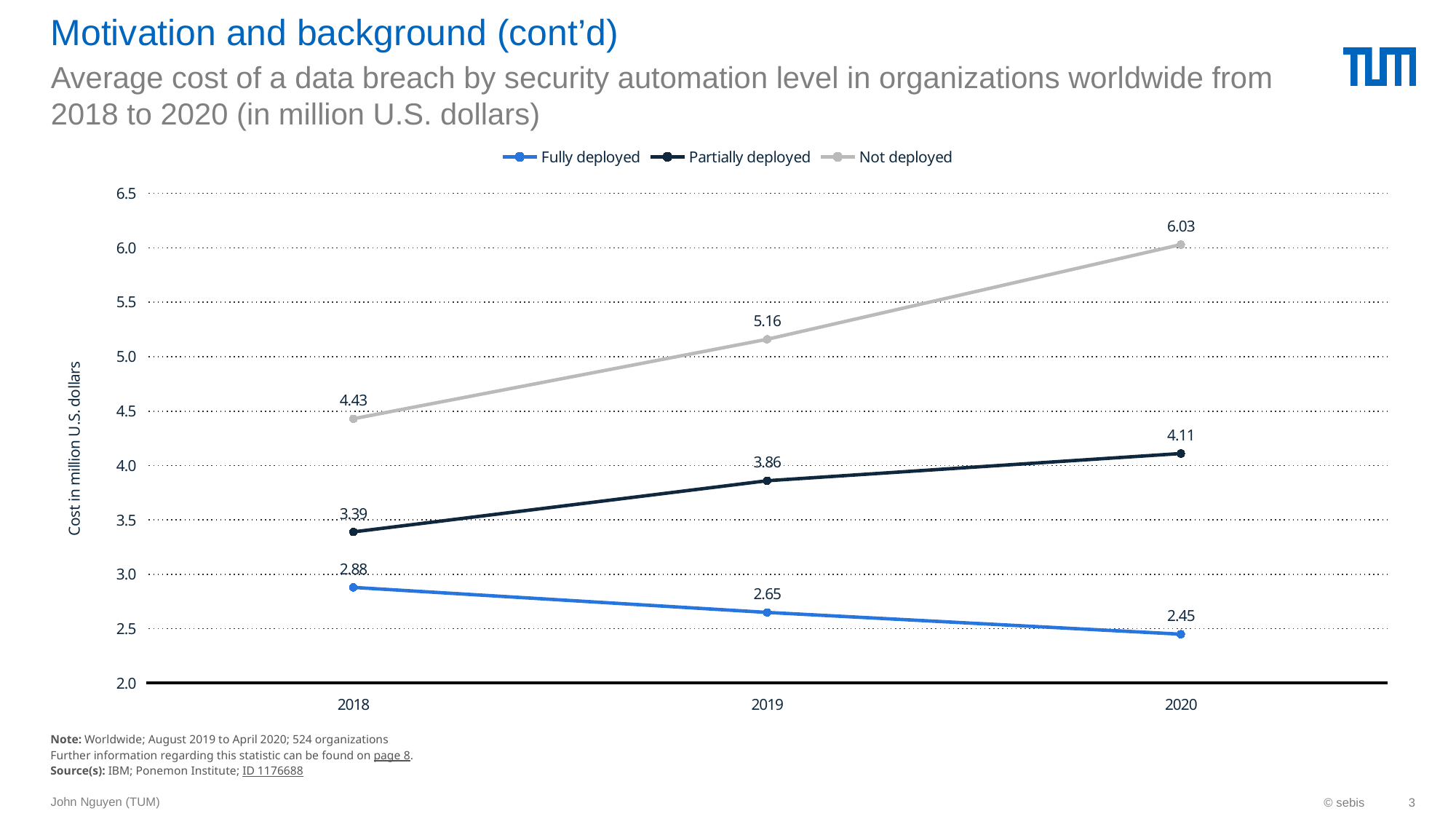
How many years are shown on the x axis? 3 What kind of chart is shown? line chart Does the Fully deployed series rise or fall from 2018 to 2020? fall What is the difference between Not deployed and Fully deployed in 2020? 3.58 How many series does the legend list? 3 What is the value for Fully deployed in 2018? 2.88 Is the value for Partially deployed in 2020 greater or less than 4.0? greater What is the value for Partially deployed in 2019? 3.86 In which year is the Not deployed series highest? 2020 In which year is the Fully deployed series lowest? 2020 What is the value for Not deployed in 2020? 6.03 Which is larger in 2018: Partially deployed or Fully deployed? Partially deployed